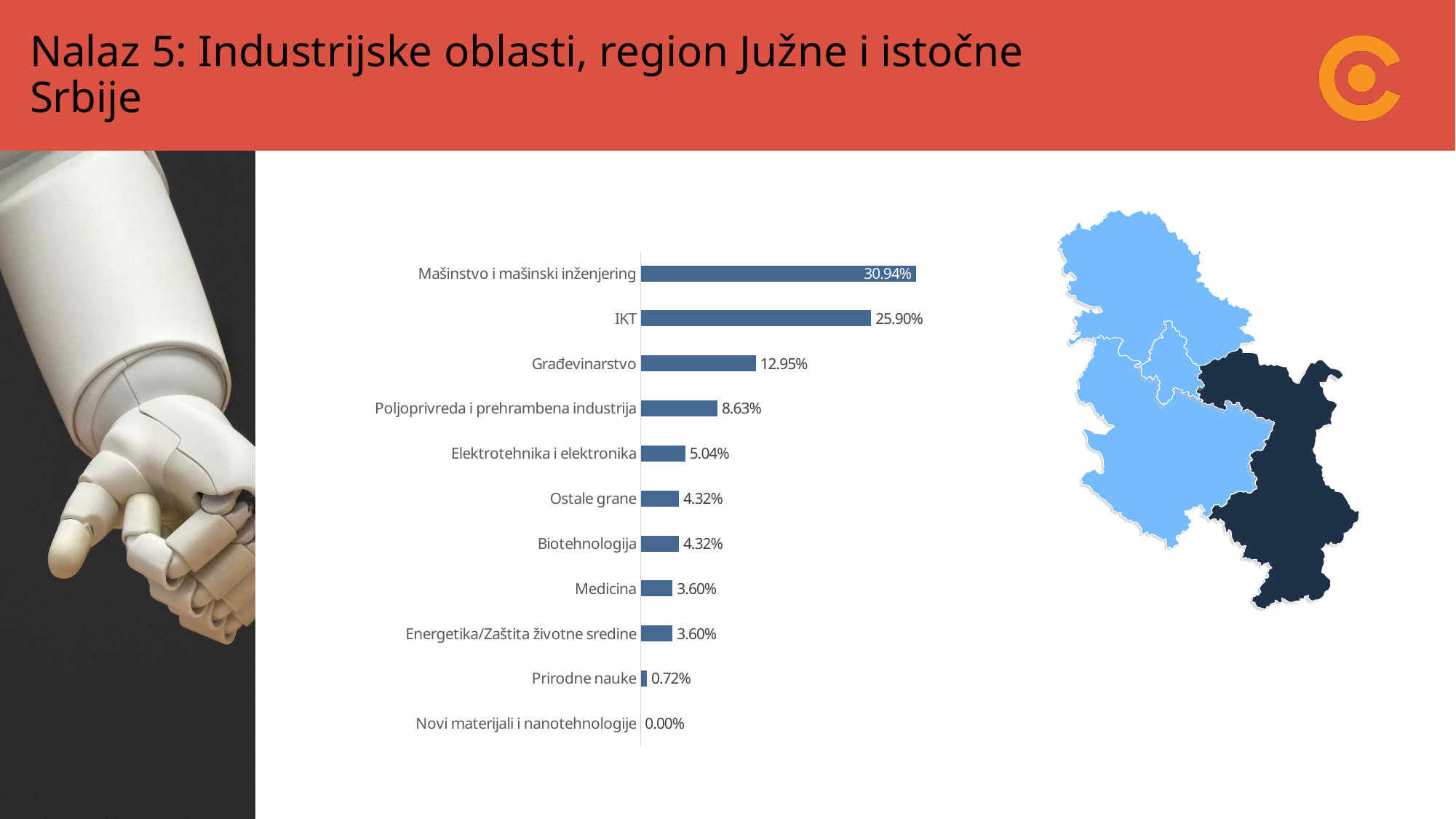
How many categories are shown in the chart? 11 Which category has the highest value? Mašinstvo i mašinski inženjering What is the value for Poljoprivreda i prehrambena industrija? 8.63% What is the value for Mašinstvo i mašinski inženjering? 30.94% What is the value for Medicina? 3.60% What is the value for Prirodne nauke? 0.72% What kind of chart is shown on the slide? Bar chart What is the difference between the values for Mašinstvo i mašinski inženjering and IKT? 5.04% Which is larger, the value for Građevinarstvo or the value for Elektrotehnika i elektronika? Građevinarstvo What is the value for IKT? 25.90% What is the value for Građevinarstvo? 12.95% Which category has the lowest value? Novi materijali i nanotehnologije